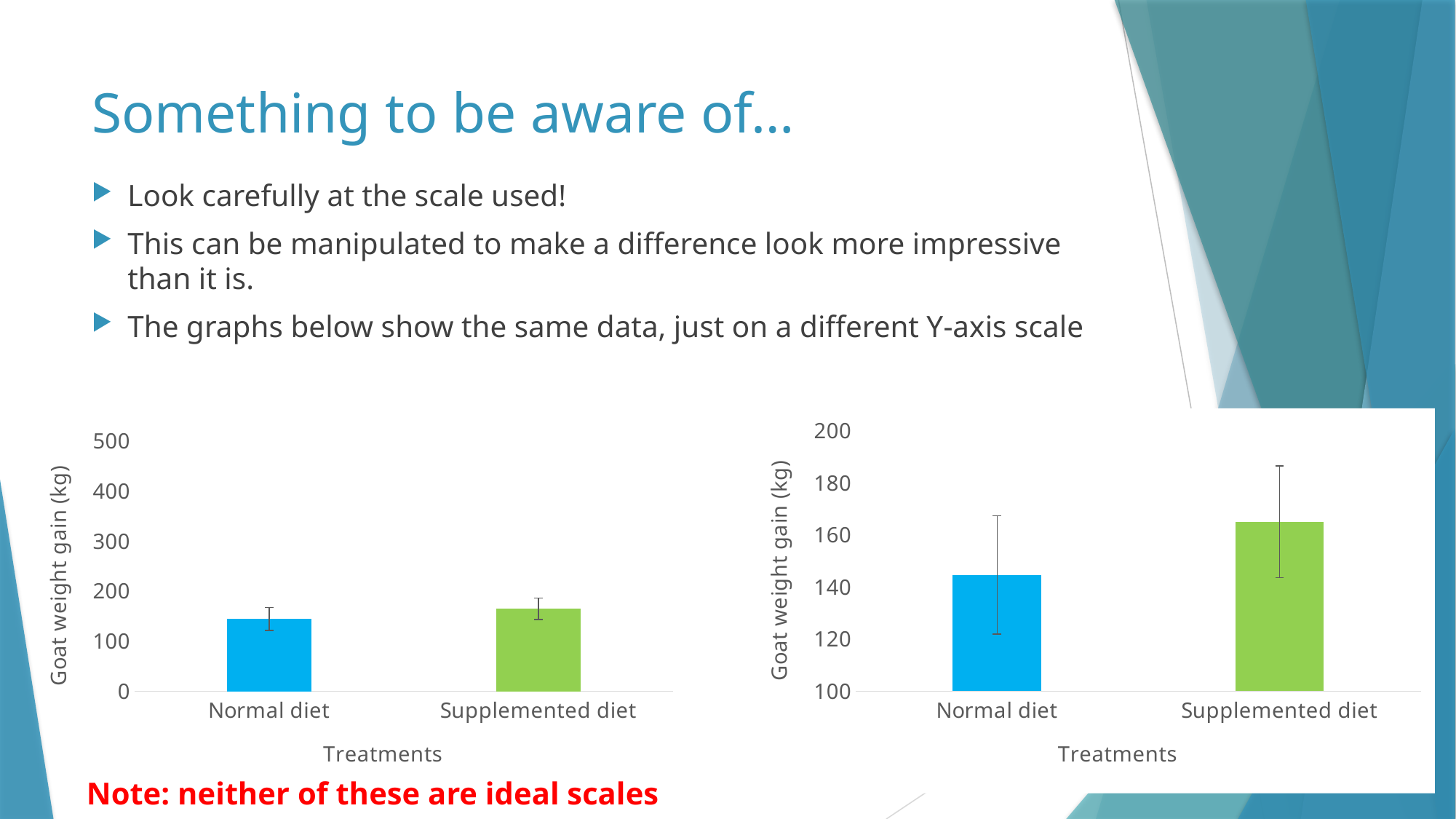
How many categories are shown on the x axis of the right chart? 2 In the right chart, is the bar for Normal diet or Supplemented diet taller? Supplemented diet What is the y-axis label of the left chart? Goat weight gain (kg) In the left chart, which treatment has the higher goat weight gain? Supplemented diet In the right chart, is the value for Normal diet greater or less than 160? less What is the lowest value shown on the y axis of the right chart? 100 What kind of chart is the left chart? bar chart In the right chart, is the value for Supplemented diet greater or less than 180? less In the right chart, is the value for Supplemented diet greater or less than 140? greater In the right chart, which treatment has the lower goat weight gain? Normal diet